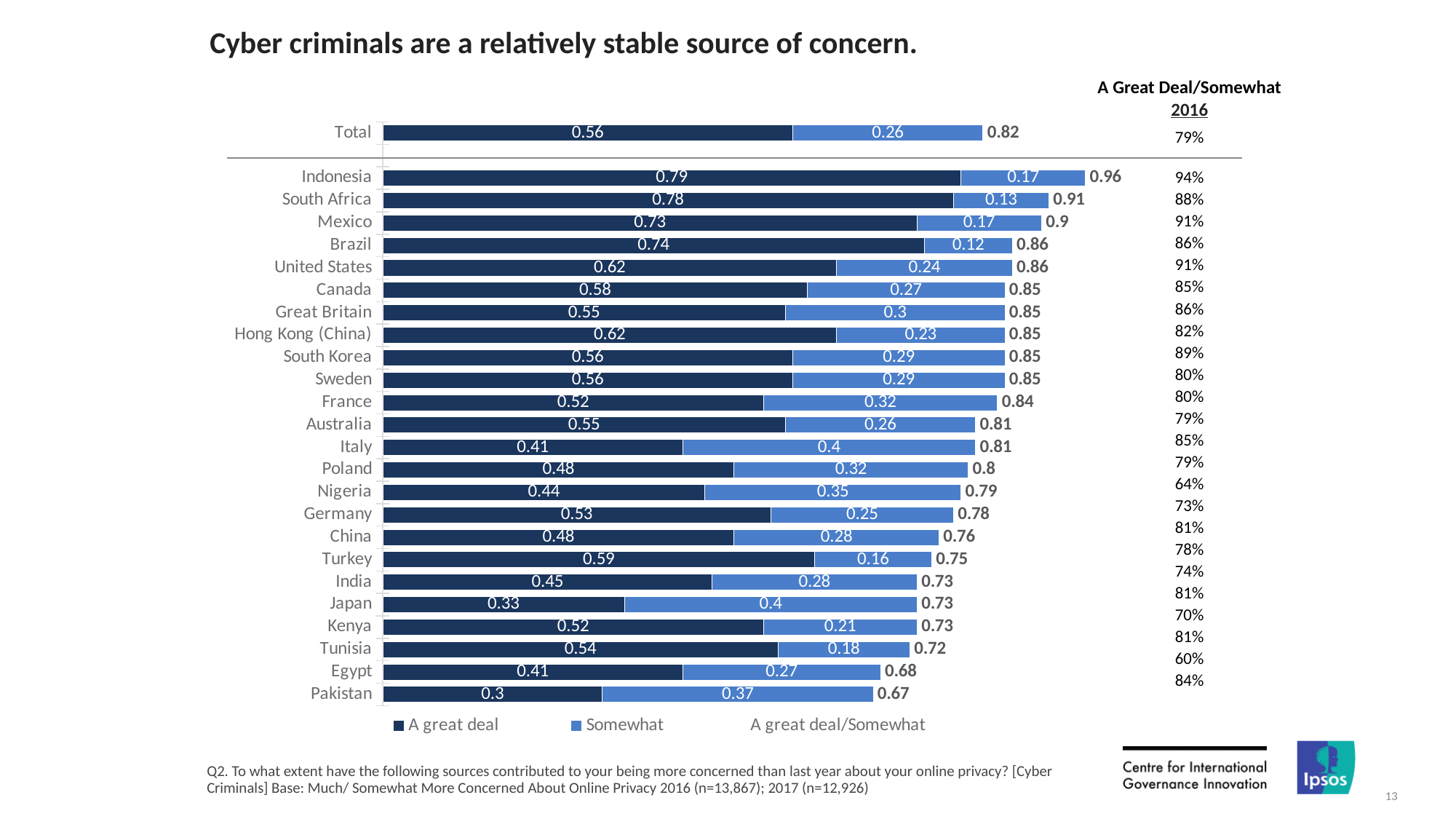
Which country has the lowest combined "A great deal/Somewhat" total? Pakistan Which has a larger "A great deal" value, United States or Italy? United States What is the difference between the "A great deal" values for Indonesia and Pakistan? 0.49 What is the "A great deal" value for Indonesia? 0.79 What is the combined "A great deal/Somewhat" total shown for Mexico? 0.9 How many countries (excluding Total) are plotted in the chart? 24 How many entries does the legend list? 3 What is the "Somewhat" value for Japan? 0.4 Which country has the highest combined "A great deal/Somewhat" total? Indonesia What is the "A great deal" value for the Total bar? 0.56 What kind of chart is shown on the slide? Stacked bar chart What is the title of the slide? Cyber criminals are a relatively stable source of concern.